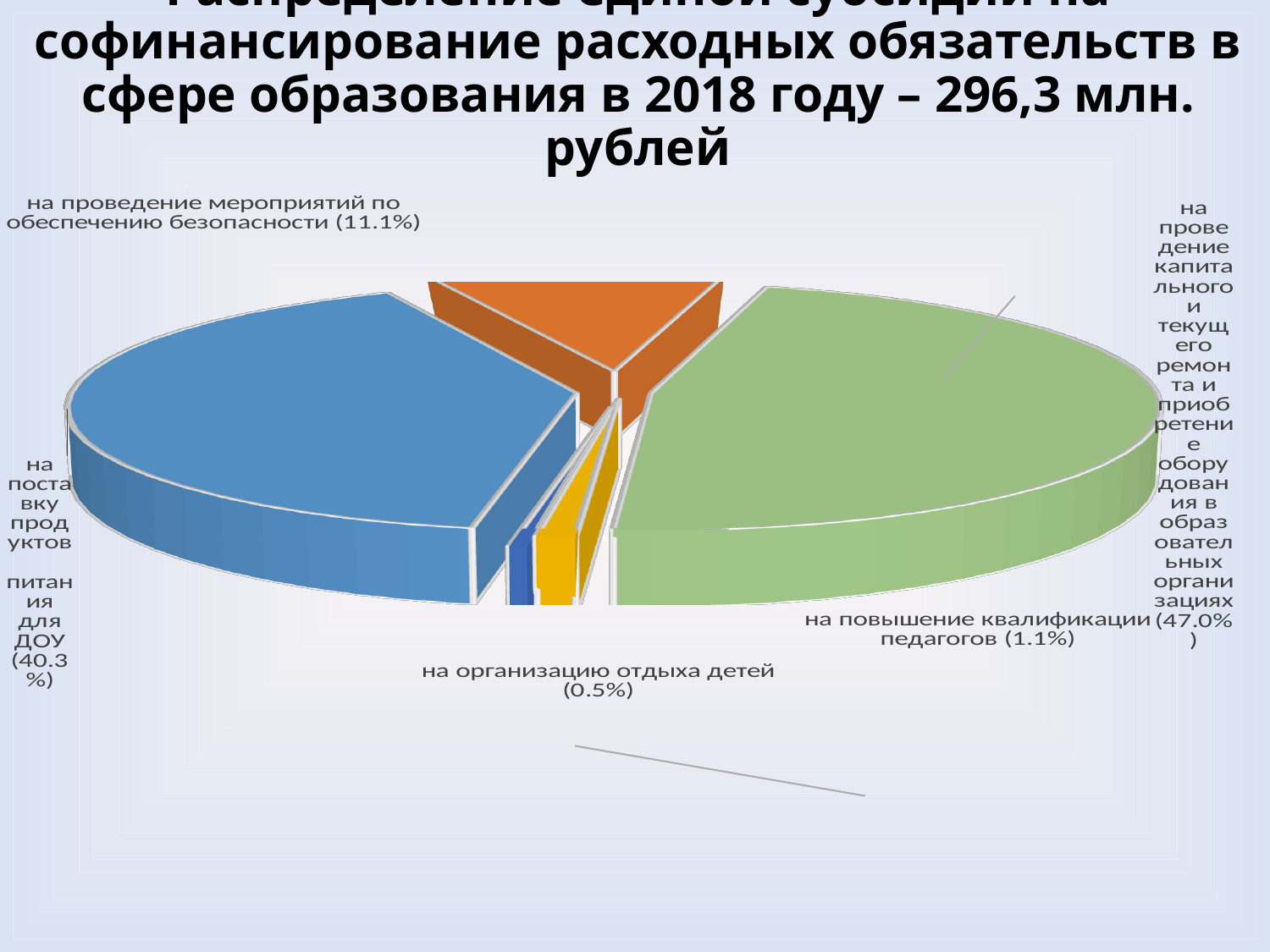
What share of the pie is labelled for 'на организацию отдыха детей'? 0.5% Which category has the largest share of the pie? на проведение капитального и текущего ремонта и приобретение оборудования в образовательных организациях What share of the pie is labelled for 'на поставку продуктов питания для ДОУ'? 40.3% Which category has the smallest share of the pie? на организацию отдыха детей Which is larger: the share for 'на проведение мероприятий по обеспечению безопасности' or the share for 'на повышение квалификации педагогов'? на проведение мероприятий по обеспечению безопасности What kind of chart is shown on the slide? Pie chart How many slices does the pie chart have? 5 What is the difference in percentage points between the share for 'на проведение капитального и текущего ремонта и приобретение оборудования в образовательных организациях' and the share for 'на поставку продуктов питания для ДОУ'? 6.7 percentage points What share of the pie is labelled for 'на проведение капитального и текущего ремонта и приобретение оборудования в образовательных организациях'? 47.0% What total amount in million rubles is stated in the slide title for 2018? 296,3 млн. рублей